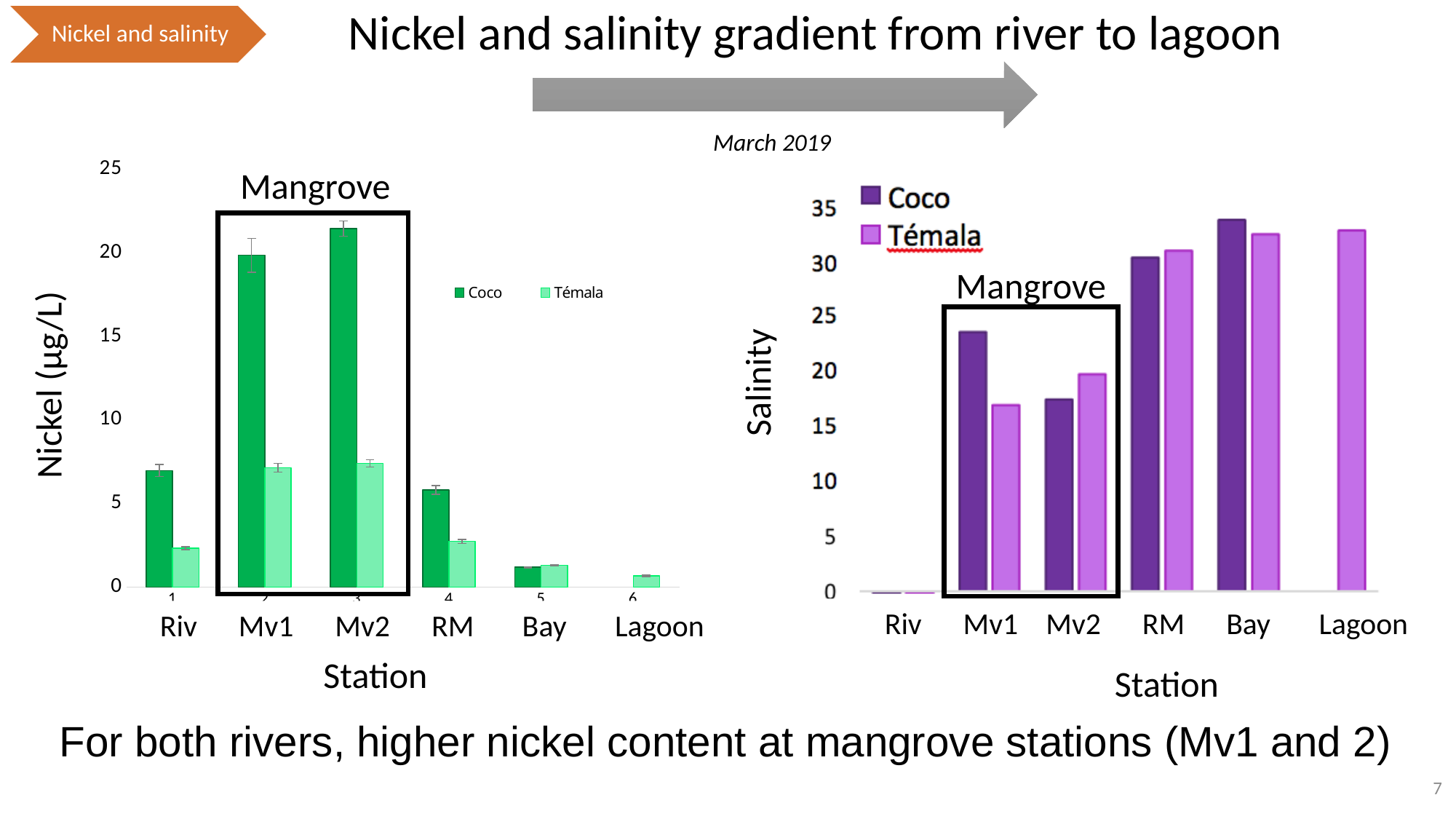
In the Salinity chart on the right, which series has the larger value at Mv2, Coco or Témala? Témala In the Nickel chart on the left, is the Coco value at Mv1 greater or less than 15? greater In the Salinity chart on the right, which series has the larger value at Mv1, Coco or Témala? Coco In the Nickel chart on the left, is the Témala value at Mv2 greater or less than 10? less In the Salinity chart on the right, is the Coco value at Bay greater or less than 30? greater In the Nickel chart on the left, which series has the larger value at Riv, Coco or Témala? Coco In the Salinity chart on the right, which station has the highest Coco salinity? Bay What is the y-axis label of the chart on the right? Salinity How many stations are shown on the x axis of the Nickel chart on the left? 6 How many series does the legend of the Nickel chart on the left list? 2 In the Nickel chart on the left, which station has the highest Coco nickel value? Mv2 What kind of chart is the Nickel (µg/L) chart on the left? bar chart